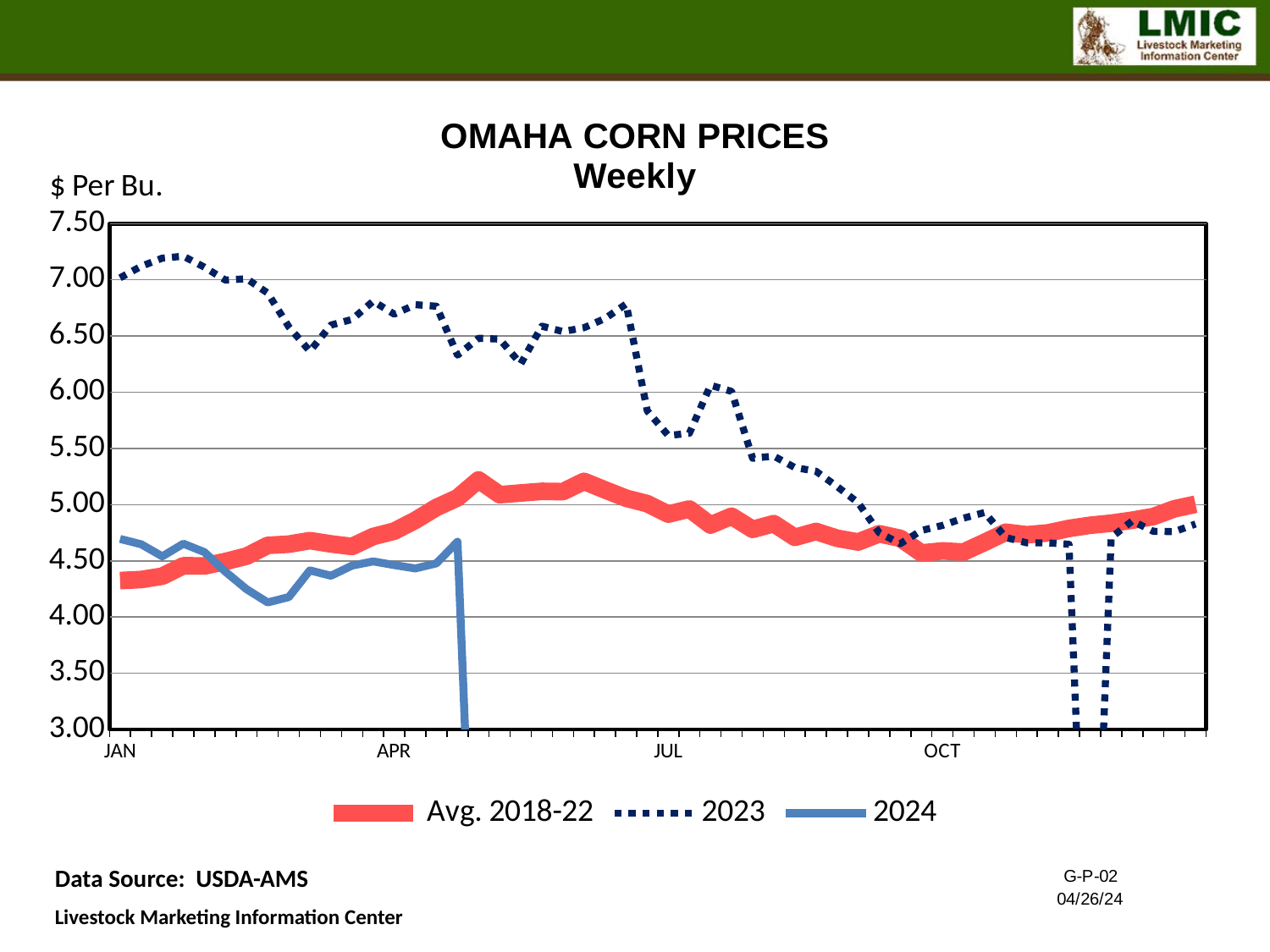
Is the value for Avg. 2018-22 at JAN greater or less than 4.50? less At JAN, which series has the higher value, 2024 or Avg. 2018-22? 2024 Is the value for Avg. 2018-22 at OCT greater or less than 5.00? less What unit label is shown on the vertical axis? $ Per Bu. How many series does the legend list? 3 What kind of chart is shown on the slide? line chart Is the value for 2023 at JAN greater or less than 6.50? greater At JAN, which series has the higher value, 2023 or 2024? 2023 Does the 2023 series generally rise or fall from JAN to OCT? fall What is the title of the chart? OMAHA CORN PRICES Weekly